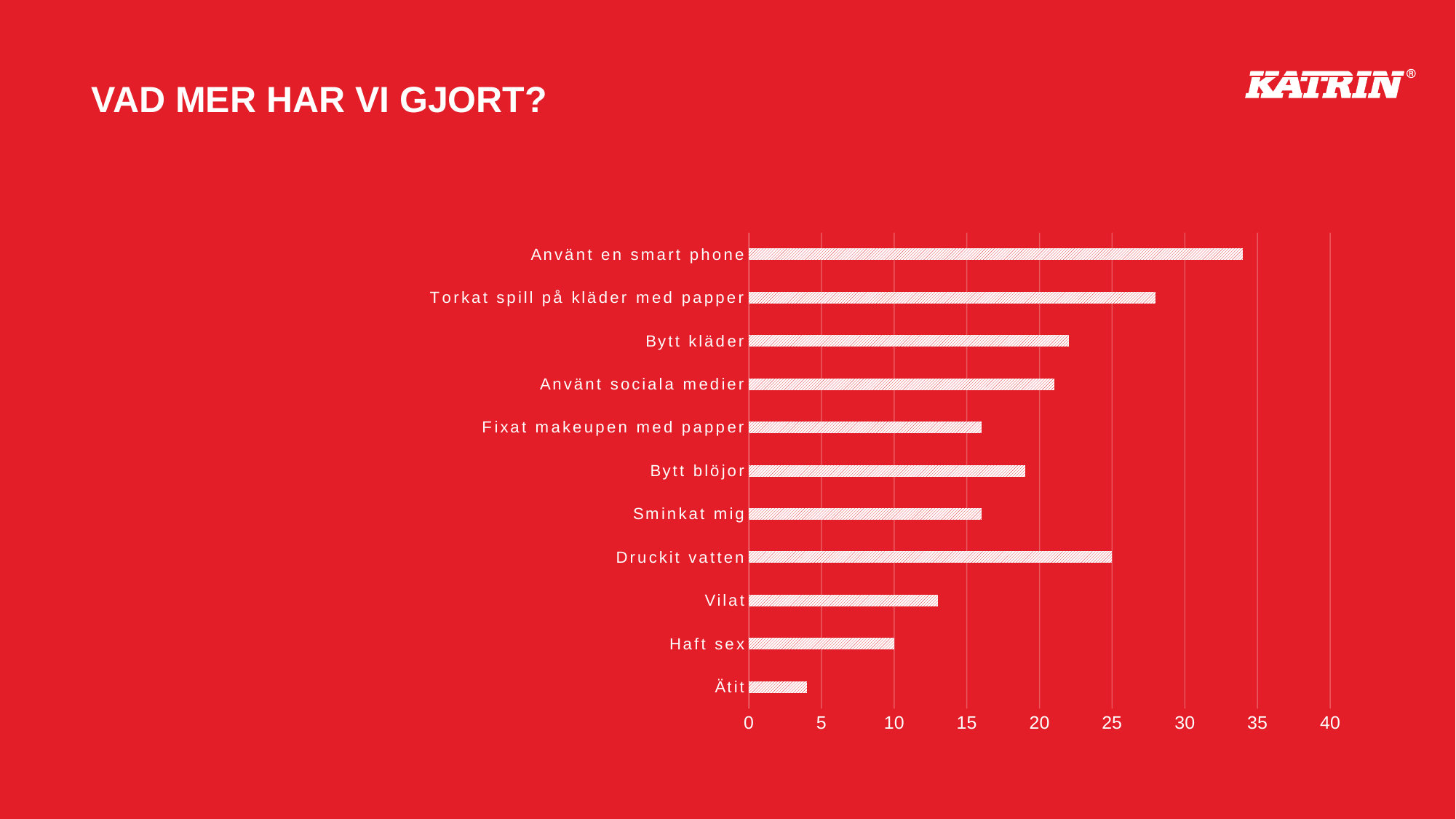
What is the value for Haft sex? 10 Which category has the highest value in the chart? Använt en smart phone Is the value for Vilat greater or less than 15? less Which is larger, the value for Torkat spill på kläder med papper or the value for Bytt kläder? Torkat spill på kläder med papper Which category has the lowest value in the chart? Ätit What kind of chart is shown on the slide? bar chart What is the title of the slide containing the chart? VAD MER HAR VI GJORT? What is the value for Druckit vatten? 25 Is the value for Ätit greater or less than 5? less How many categories are plotted in the chart? 11 Which is larger, the value for Bytt blöjor or the value for Sminkat mig? Bytt blöjor Is the value for Använt en smart phone greater or less than 30? greater